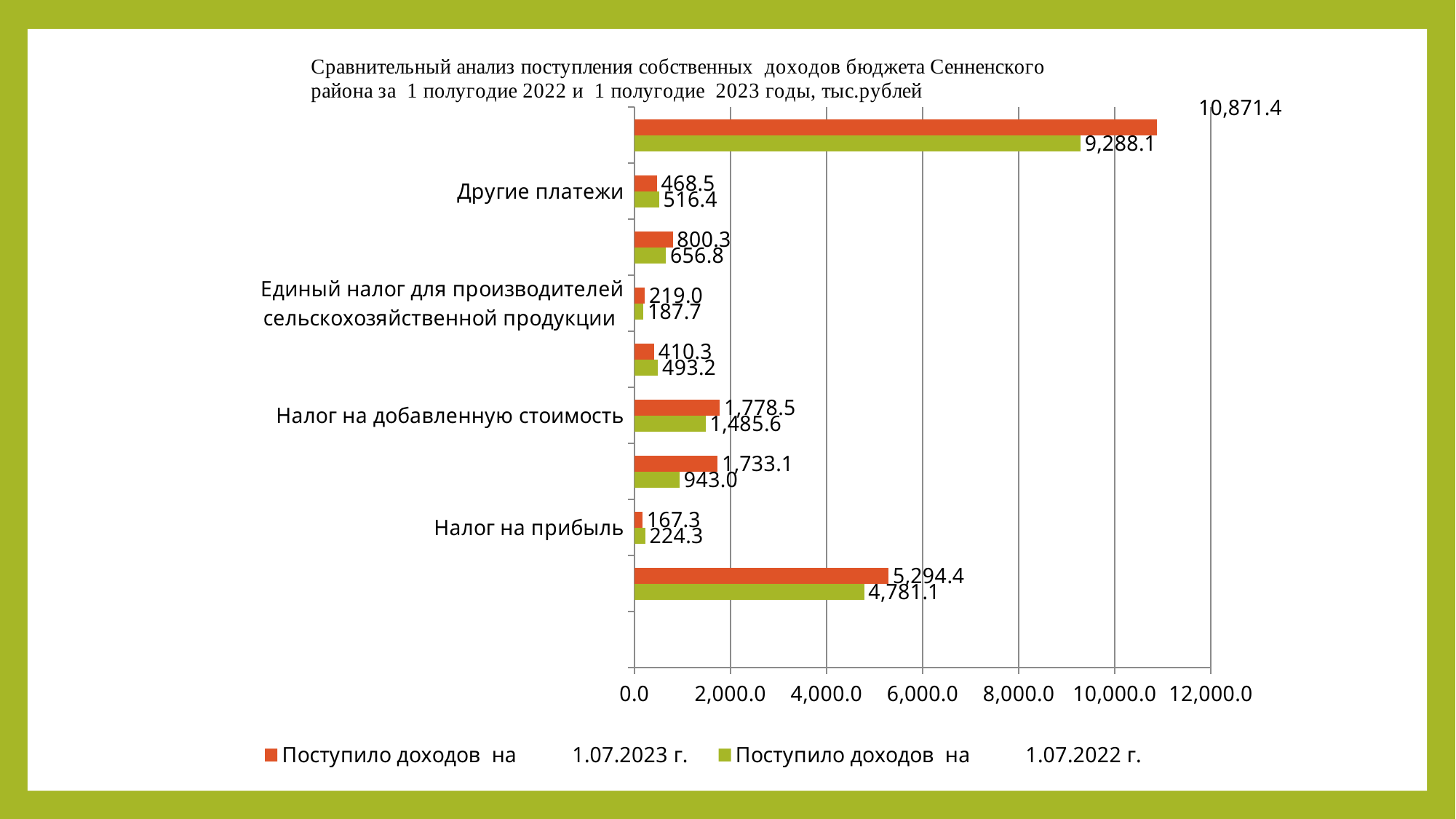
What is the difference between the 1.07.2023 and 1.07.2022 values for Налог на добавленную стоимость? 292.9 What is the value for Налог на прибыль in the series Поступило доходов на 1.07.2023 г.? 167.3 What is the value for Налог на добавленную стоимость in the series Поступило доходов на 1.07.2022 г.? 1,485.6 How many series does the legend list? 2 What is the value for Другие платежи in the series Поступило доходов на 1.07.2022 г.? 516.4 What kind of chart is shown on the slide? Bar chart What is the difference between the 1.07.2022 and 1.07.2023 values for Налог на прибыль? 57.0 Is the value for Налог на добавленную стоимость in the series Поступило доходов на 1.07.2023 г. greater or less than 2,000.0? less For Налог на прибыль, which series has the larger value: Поступило доходов на 1.07.2023 г. or Поступило доходов на 1.07.2022 г.? Поступило доходов на 1.07.2022 г. What is the largest value labelled on the chart? 10,871.4 What is the value for Единый налог для производителей сельскохозяйственной продукции in the series Поступило доходов на 1.07.2023 г.? 219.0 What is the value for Налог на добавленную стоимость in the series Поступило доходов на 1.07.2023 г.? 1,778.5